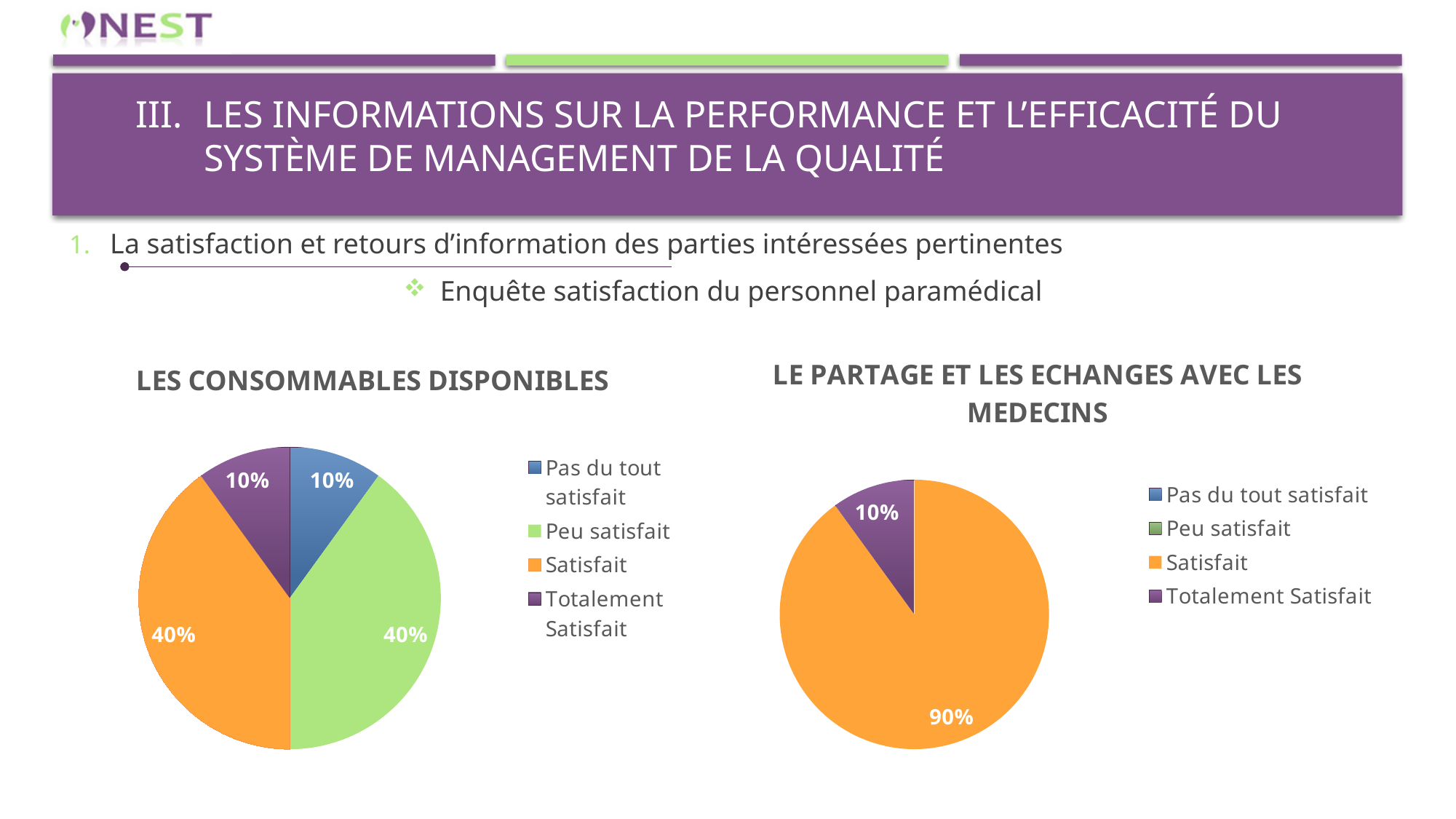
In the chart titled 'LES CONSOMMABLES DISPONIBLES', which is larger: the 'Satisfait' slice or the 'Totalement Satisfait' slice? Satisfait In the chart titled 'LES CONSOMMABLES DISPONIBLES', what share is labelled for 'Peu satisfait'? 40% In the chart titled 'LES CONSOMMABLES DISPONIBLES', how many entries does the legend list? 4 In the chart titled 'LE PARTAGE ET LES ECHANGES AVEC LES MEDECINS', which category has the largest slice? Satisfait What type of chart is the one titled 'LE PARTAGE ET LES ECHANGES AVEC LES MEDECINS'? Pie chart In the chart titled 'LES CONSOMMABLES DISPONIBLES', what share is labelled for 'Pas du tout satisfait'? 10% In the chart titled 'LES CONSOMMABLES DISPONIBLES', what share is labelled for 'Totalement Satisfait'? 10% In the chart titled 'LES CONSOMMABLES DISPONIBLES', what colour is the 'Satisfait' slice? Orange In the chart titled 'LES CONSOMMABLES DISPONIBLES', what is the difference between the 'Satisfait' share and the 'Pas du tout satisfait' share? 30% In the chart titled 'LE PARTAGE ET LES ECHANGES AVEC LES MEDECINS', what share is labelled for 'Totalement Satisfait'? 10% In the chart titled 'LE PARTAGE ET LES ECHANGES AVEC LES MEDECINS', what share is labelled for 'Satisfait'? 90% In the chart titled 'LE PARTAGE ET LES ECHANGES AVEC LES MEDECINS', what is the difference between the 'Satisfait' share and the 'Totalement Satisfait' share? 80%